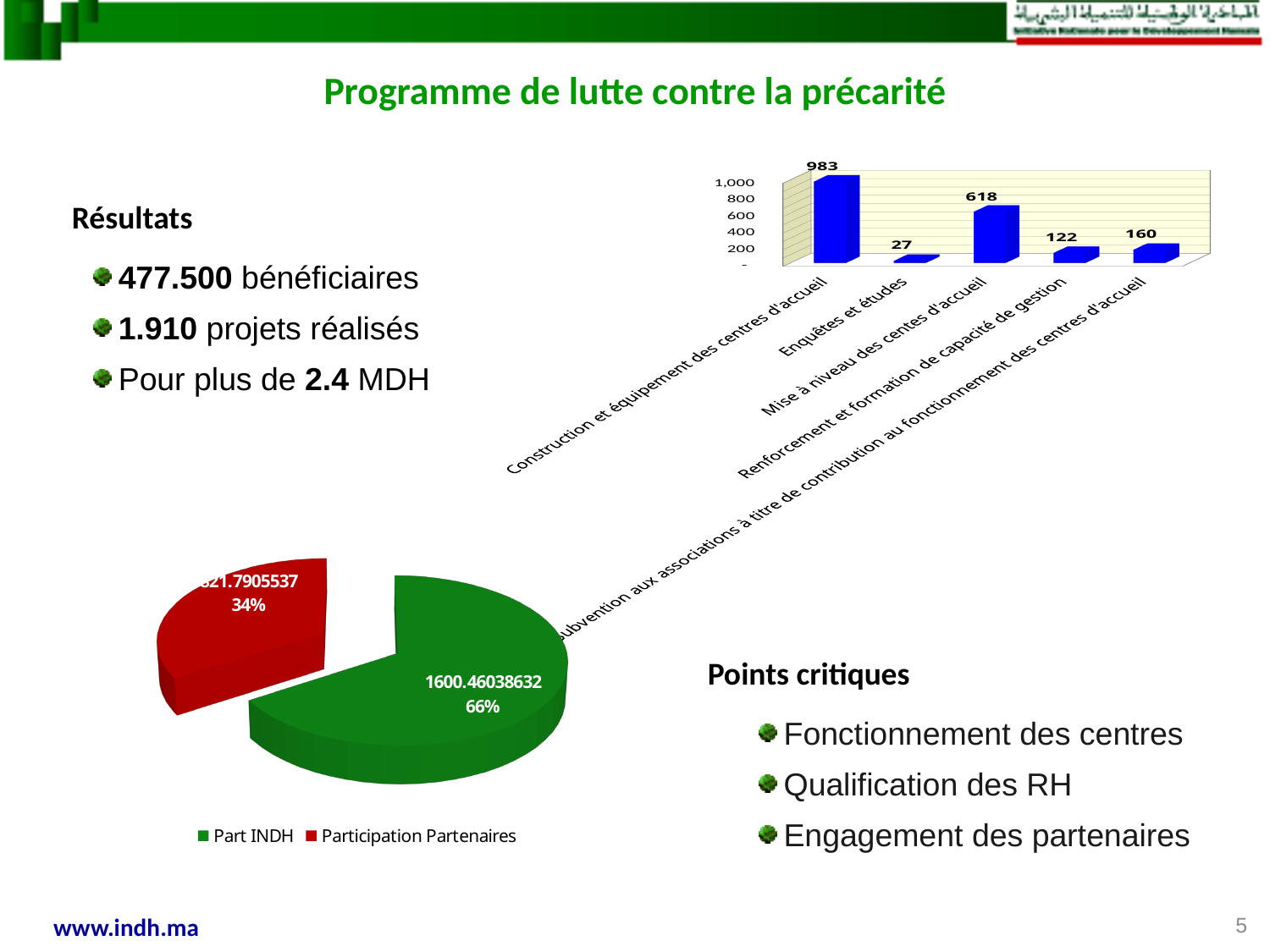
In the bar chart at the top right, which category has the lowest value? Enquêtes et études How many categories are shown in the bar chart at the top right? 5 In the bar chart at the top right, what is the value for Mise à niveau des centres d'accueil? 618 In the pie chart at the bottom left, what share does Part INDH represent? 66% In the bar chart at the top right, what is the value for Enquêtes et études? 27 In the bar chart at the top right, what is the difference between the values for Construction et équipement des centres d'accueil and Mise à niveau des centres d'accueil? 365 In the bar chart at the top right, what is the value for Construction et équipement des centres d'accueil? 983 What type of chart is shown at the bottom left of the slide? Pie chart In the bar chart at the top right, which is larger: the value for Renforcement et formation de capacité de gestion or the value for Subvention aux associations à titre de contribution au fonctionnement des centres d'accueil? Subvention aux associations à titre de contribution au fonctionnement des centres d'accueil In the pie chart at the bottom left, what share does Participation Partenaires represent? 34% In the bar chart at the top right, which category has the highest value? Construction et équipement des centres d'accueil In the bar chart at the top right, what is the value for Renforcement et formation de capacité de gestion? 122